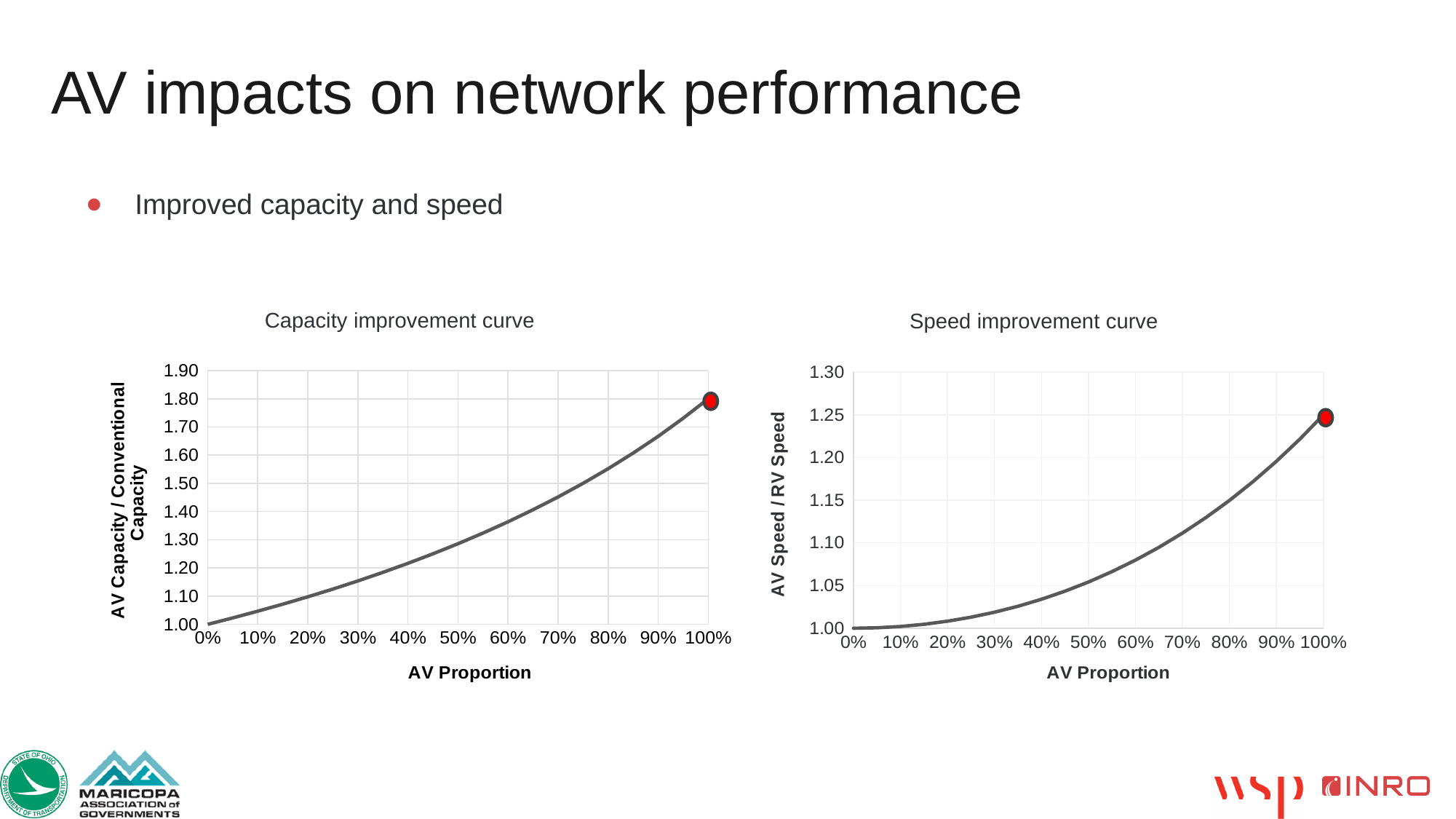
What type of chart is the Capacity improvement curve? line chart In the Speed improvement curve, is the value at 50% AV Proportion greater or less than 1.10? less In the Capacity improvement curve, at which AV Proportion is the value lowest? 0% In the Capacity improvement curve, do the values rise or fall as AV Proportion increases? rise In the Speed improvement curve, at which AV Proportion is the value highest? 100% What is the x-axis label of the Speed improvement curve? AV Proportion In the Capacity improvement curve, what is the value at an AV Proportion of 0%? 1.00 In the Capacity improvement curve, is the value at 100% AV Proportion greater or less than 1.70? greater What type of chart is the Speed improvement curve? line chart In the Speed improvement curve, is the value at 100% AV Proportion greater or less than 1.20? greater In the Speed improvement curve, what is the value at an AV Proportion of 0%? 1.00